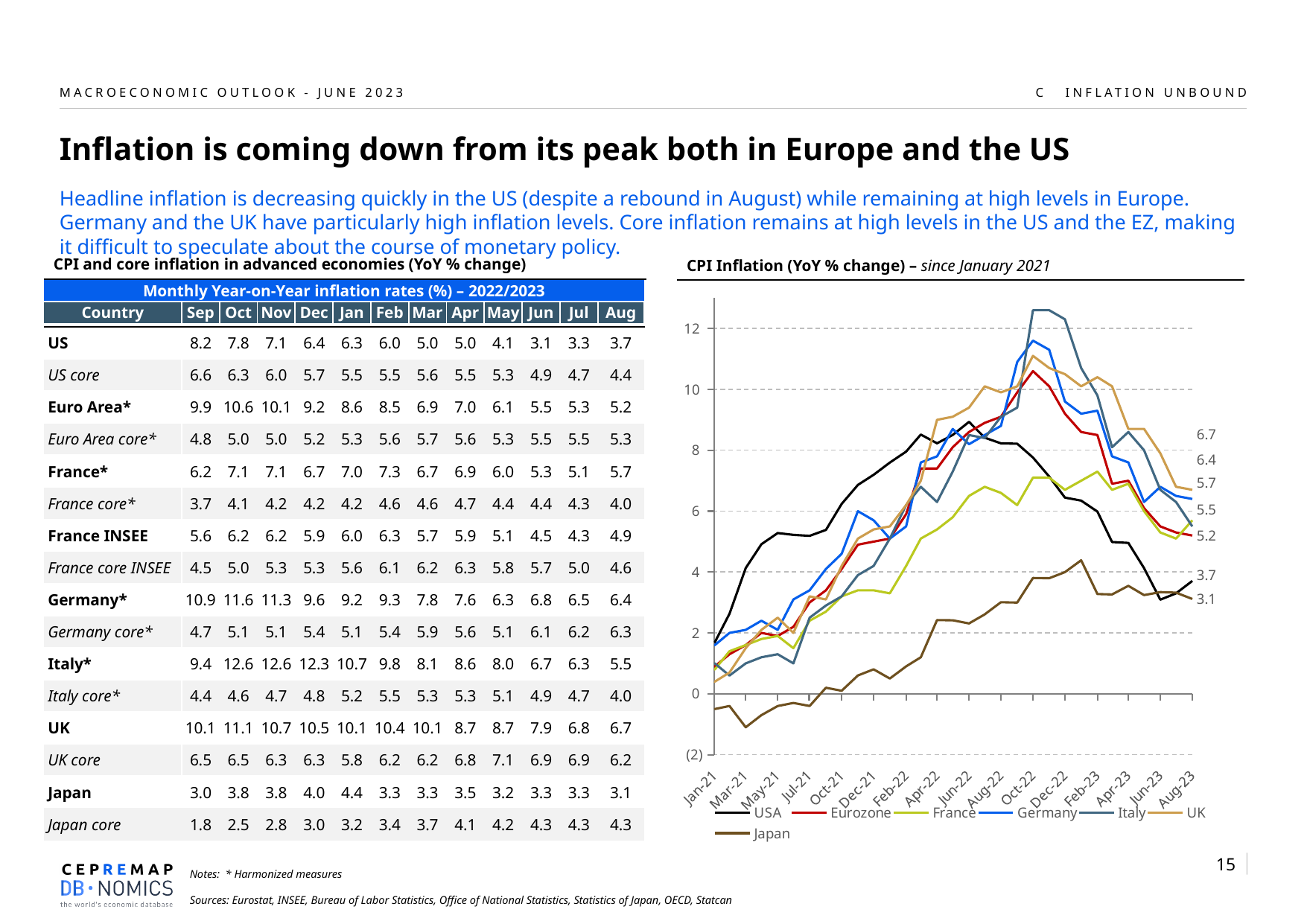
In the CPI Inflation chart, what is the difference between the final labelled values of the UK and USA lines? 3.0 Which series in the CPI Inflation chart has the highest value at the end of the series (Aug-23)? UK How many series does the legend of the CPI Inflation chart list? 7 In the CPI Inflation chart, which has the higher final labelled value, Germany or France? Germany In the CPI Inflation chart, does the USA line rise or fall between Jun-22 and Aug-23? fall Which series in the CPI Inflation chart has the lowest value at the end of the series (Aug-23)? Japan In the CPI Inflation chart, what is the final labelled value for the Japan line? 3.1 In the CPI Inflation chart, what is the final labelled value for the UK line? 6.7 What kind of chart is the 'CPI Inflation (YoY % change) – since January 2021' chart? line chart What colour is the USA line in the CPI Inflation chart? black In the CPI Inflation chart, is the peak value of the Italy line greater or less than 12? greater In the CPI Inflation chart, is the value for Japan in Jan-21 greater or less than 0? less